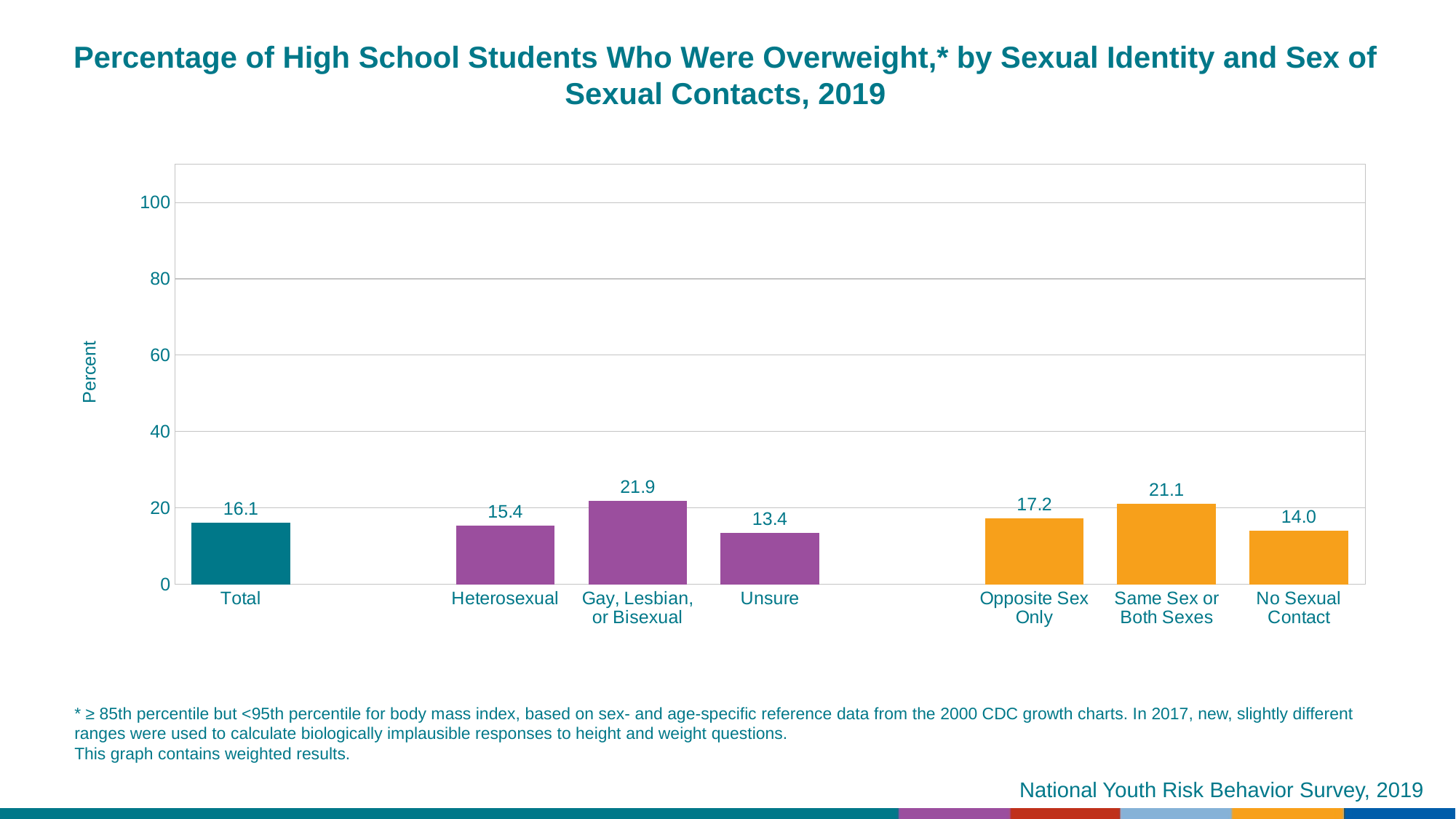
What is the value for No Sexual Contact? 14.0 Which category has the highest value? Gay, Lesbian, or Bisexual Is the value for Gay, Lesbian, or Bisexual greater or less than 20? greater Which is larger, the value for Heterosexual or the value for Unsure? Heterosexual Which category has the lowest value? Unsure What is the label of the y axis? Percent What is the difference between the values for Same Sex or Both Sexes and Opposite Sex Only? 3.9 What is the difference between the values for Total and Heterosexual? 0.7 What is the value for Total? 16.1 What kind of chart is shown on the slide? bar chart How many categories are plotted in the chart? 7 What is the value for Gay, Lesbian, or Bisexual students? 21.9